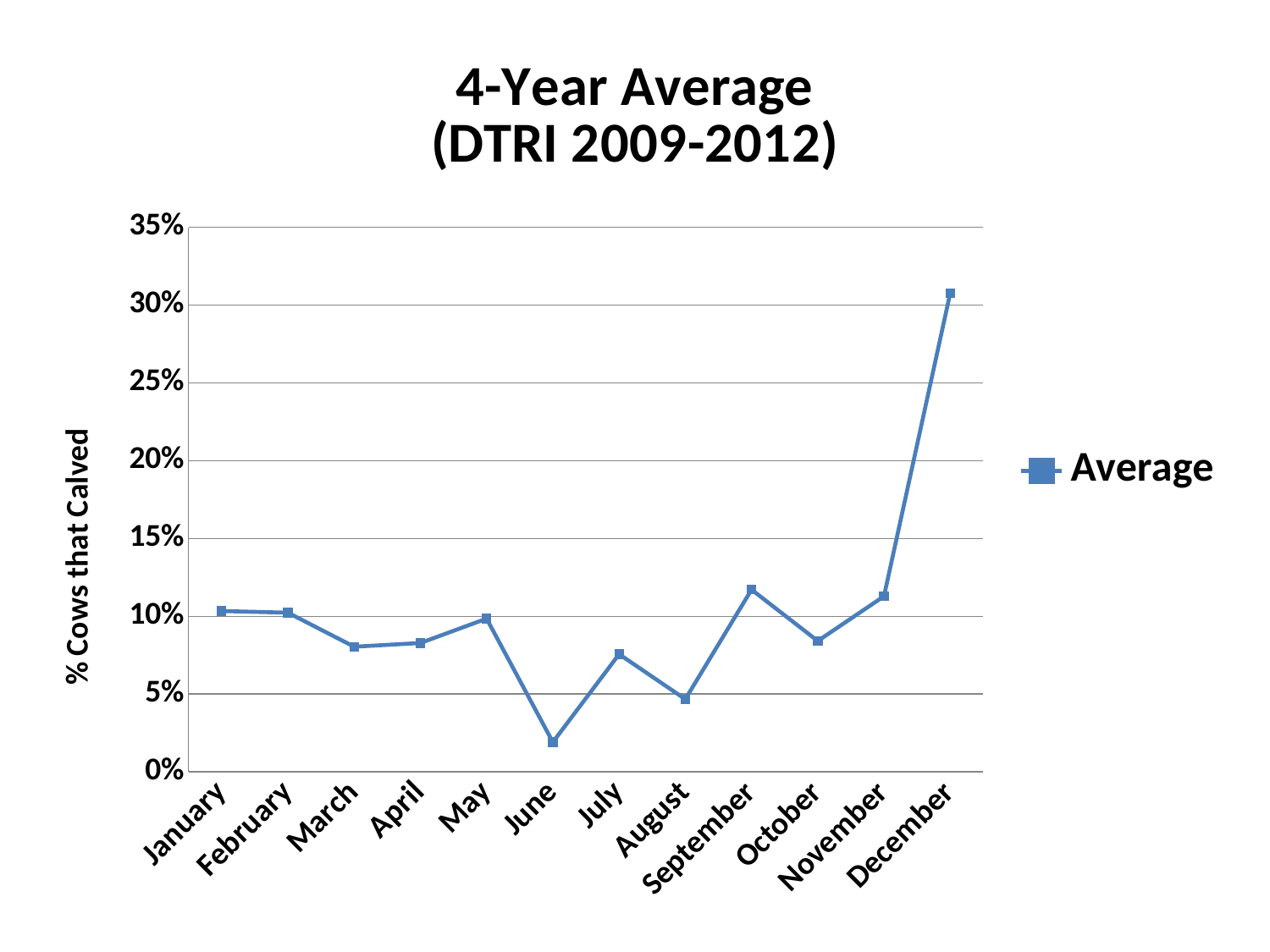
Does the value rise or fall from January to March? fall Which is larger, the value for September or the value for August? September What kind of chart is shown on the slide? line chart Is the value for June greater or less than 5%? less Which is larger, the value for May or the value for June? May How many series does the legend list? 1 Which month has the highest average percentage of cows that calved? December Which month has the lowest average percentage of cows that calved? June What is the label on the y axis? % Cows that Calved Is the value for December greater or less than 25%? greater How many months are plotted along the x axis? 12 Is the value for March greater or less than 10%? less